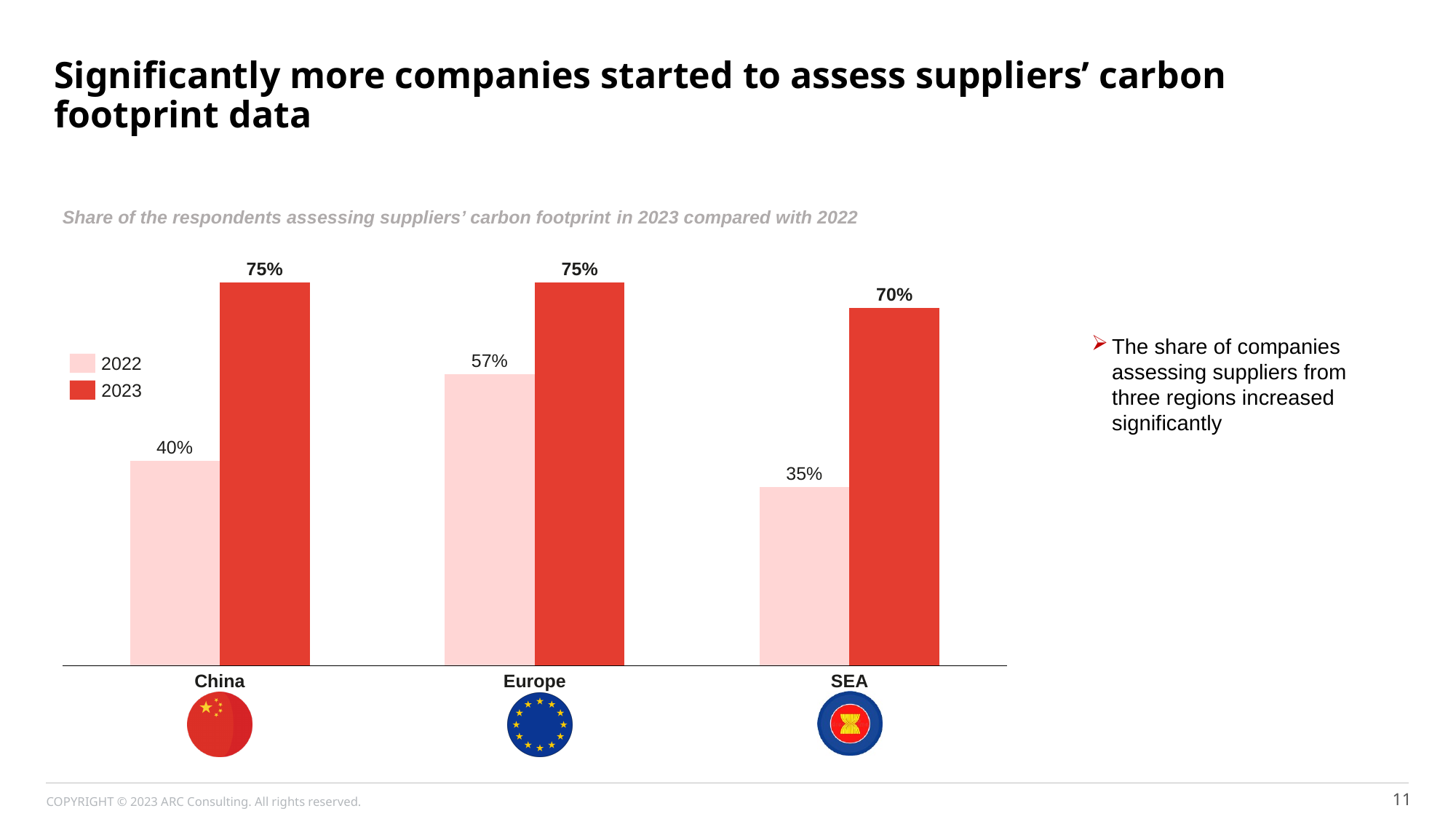
How many series does the legend list? 2 Which region has the lowest 2023 value? SEA What is the 2023 value for Europe? 75% Which region has the highest 2022 value? Europe What is the 2022 value for China? 40% Which is larger, the 2022 value for China or the 2022 value for SEA? China What is the 2023 value for SEA? 70% What is the 2022 value for SEA? 35% Which region has the lowest 2022 value? SEA How many regions are shown on the chart? 3 What is the difference between the 2023 and 2022 values for Europe? 18 percentage points What is the difference between the 2023 and 2022 values for China? 35 percentage points